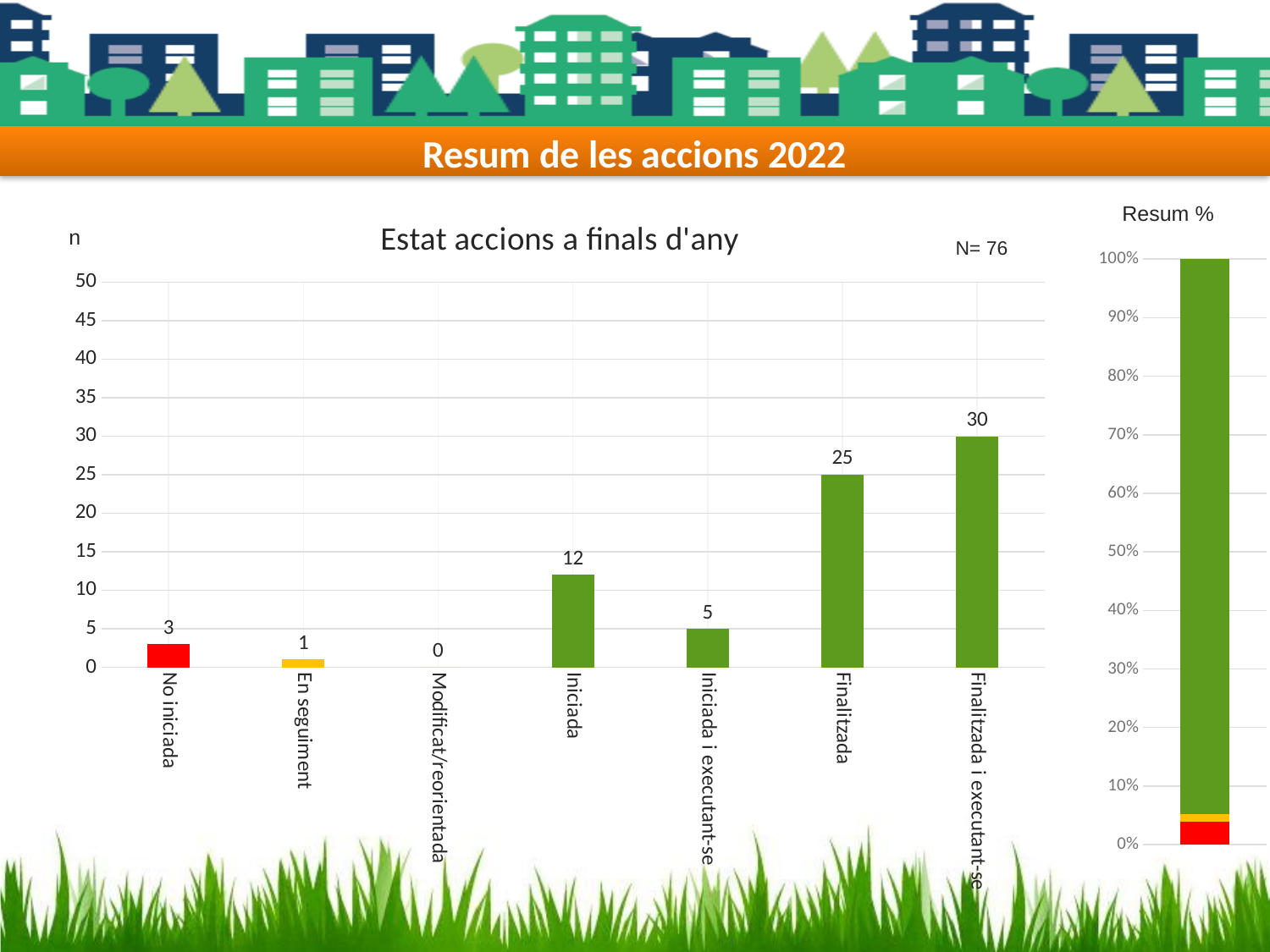
In the 'Estat accions a finals d'any' chart, what is the value for Finalitzada? 25 In the 'Estat accions a finals d'any' chart, how many categories are shown on the x axis? 7 In the 'Resum %' chart on the right, is the green segment greater or less than 90%? greater In the 'Estat accions a finals d'any' chart, which is larger: Iniciada or Iniciada i executant-se? Iniciada What kind of chart is 'Estat accions a finals d'any'? Bar chart In the 'Estat accions a finals d'any' chart, what is the value for Iniciada? 12 In the 'Estat accions a finals d'any' chart, what is the value for No iniciada? 3 In the 'Estat accions a finals d'any' chart, what is the difference between Finalitzada i executant-se and Finalitzada? 5 In the 'Estat accions a finals d'any' chart, which category has the lowest value? Modificat/reorientada In the 'Estat accions a finals d'any' chart, what is the value for Modificat/reorientada? 0 In the 'Estat accions a finals d'any' chart, which category has the highest value? Finalitzada i executant-se In the 'Estat accions a finals d'any' chart, what is the value of N shown near the title? N= 76